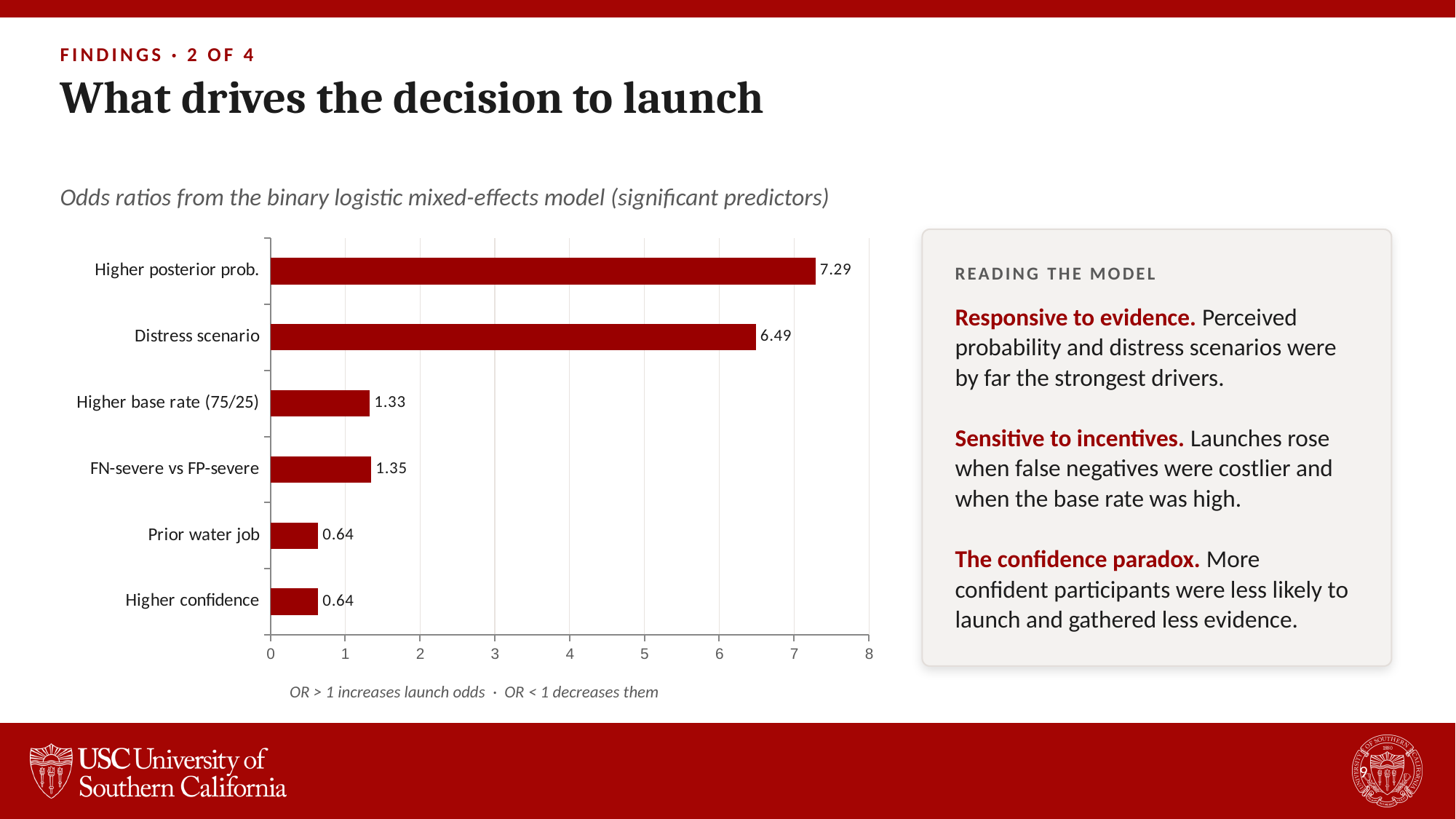
Which predictor has the highest odds ratio? Higher posterior prob. What is the difference between the odds ratios for Higher posterior prob. and Distress scenario? 0.80 What kind of chart is shown on the slide? Bar chart What is the difference between the odds ratios for FN-severe vs FP-severe and Higher base rate (75/25)? 0.02 How many predictors are shown in the chart? 6 What is the maximum value shown on the x axis of the chart? 8 Is the odds ratio for Distress scenario greater or less than 6? greater What is the odds ratio for Higher base rate (75/25)? 1.33 What is the odds ratio for Prior water job? 0.64 Which has a larger odds ratio, Distress scenario or Higher base rate (75/25)? Distress scenario What is the odds ratio for Distress scenario? 6.49 What is the odds ratio for Higher posterior prob.? 7.29